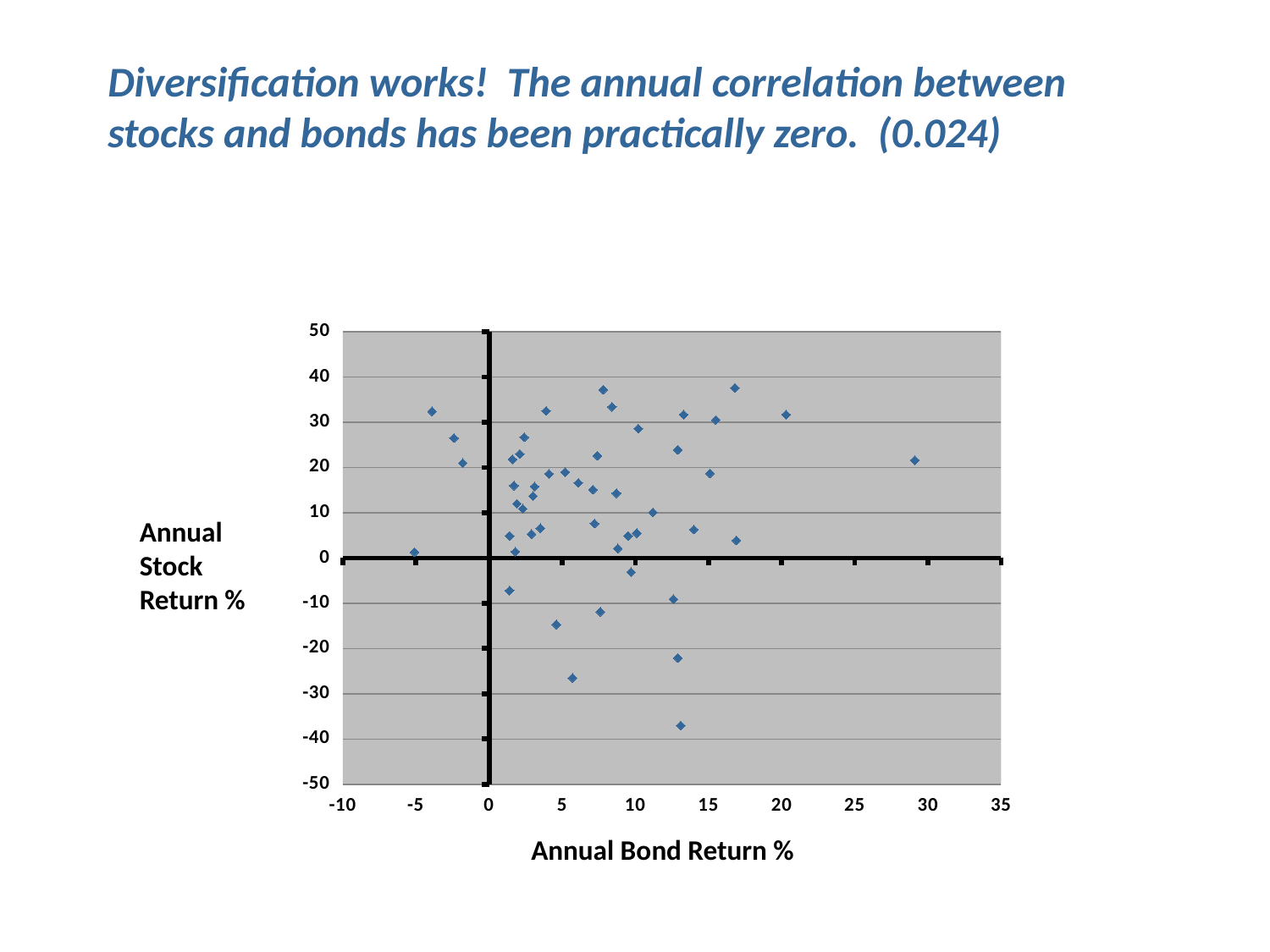
Is the bond return of the leftmost point on the chart greater or less than 0? less Is the stock return of the highest point on the chart greater or less than 30? greater Is the bond return of the rightmost point on the chart greater or less than 25? greater What is the title of the horizontal axis of the chart? Annual Bond Return % What kind of chart is shown on the slide? scatter plot What is the title of the vertical axis of the chart? Annual Stock Return % Do the points on the chart show a clear rising or falling trend as bond return increases? no clear trend